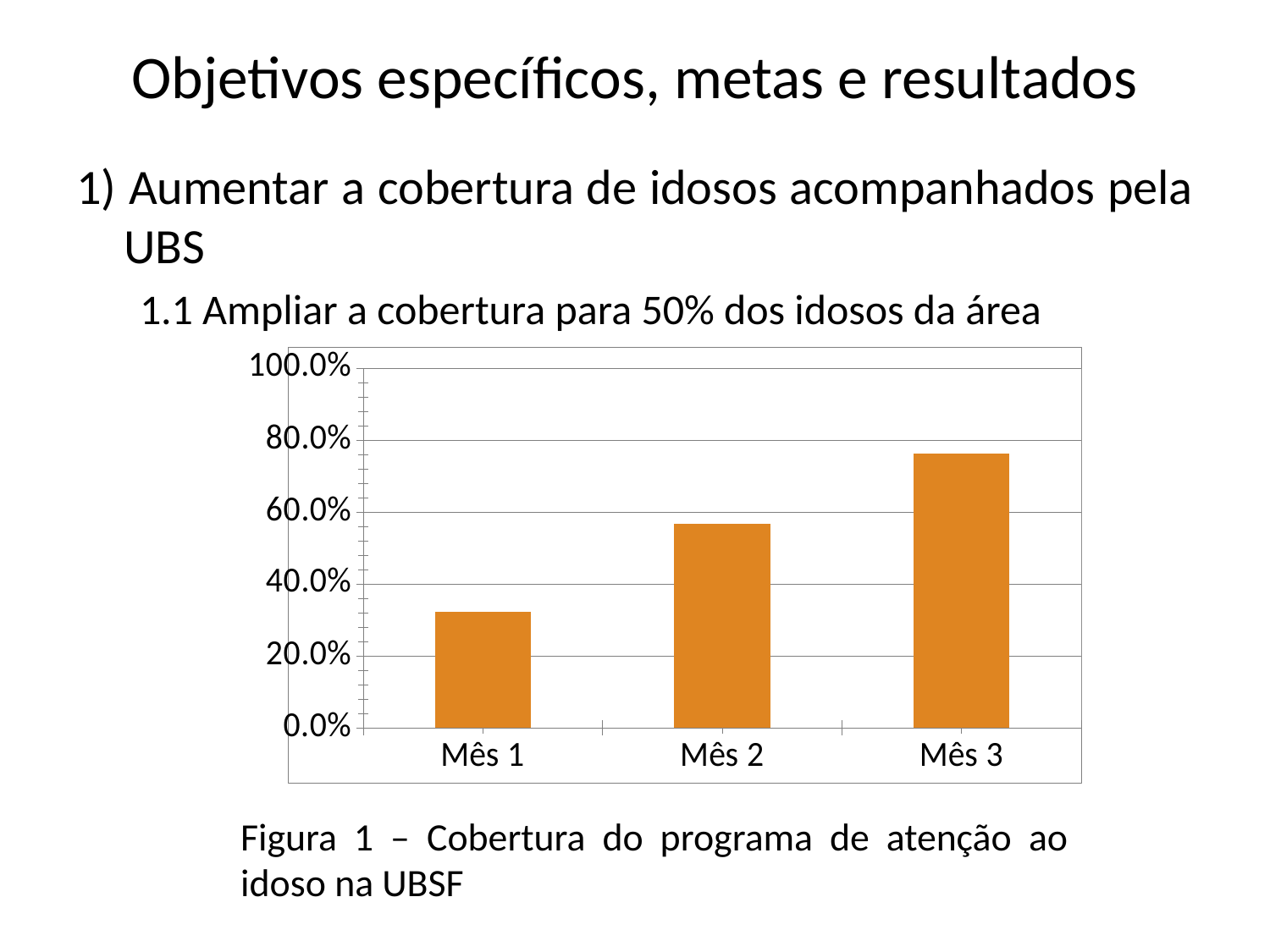
Is the value for Mês 1 greater or less than 40.0%? less Is the value for Mês 3 greater or less than 80.0%? less Is the value for Mês 1 greater or less than 20.0%? greater What kind of chart is shown on the slide? bar chart Which month has the highest coverage value in the chart? Mês 3 Which is larger, the value for Mês 2 or the value for Mês 3? Mês 3 Do the values rise or fall from Mês 1 to Mês 3? rise Which month has the lowest coverage value in the chart? Mês 1 How many categories (months) are plotted in the chart? 3 What is the caption given for the chart (Figura 1)? Figura 1 – Cobertura do programa de atenção ao idoso na UBSF